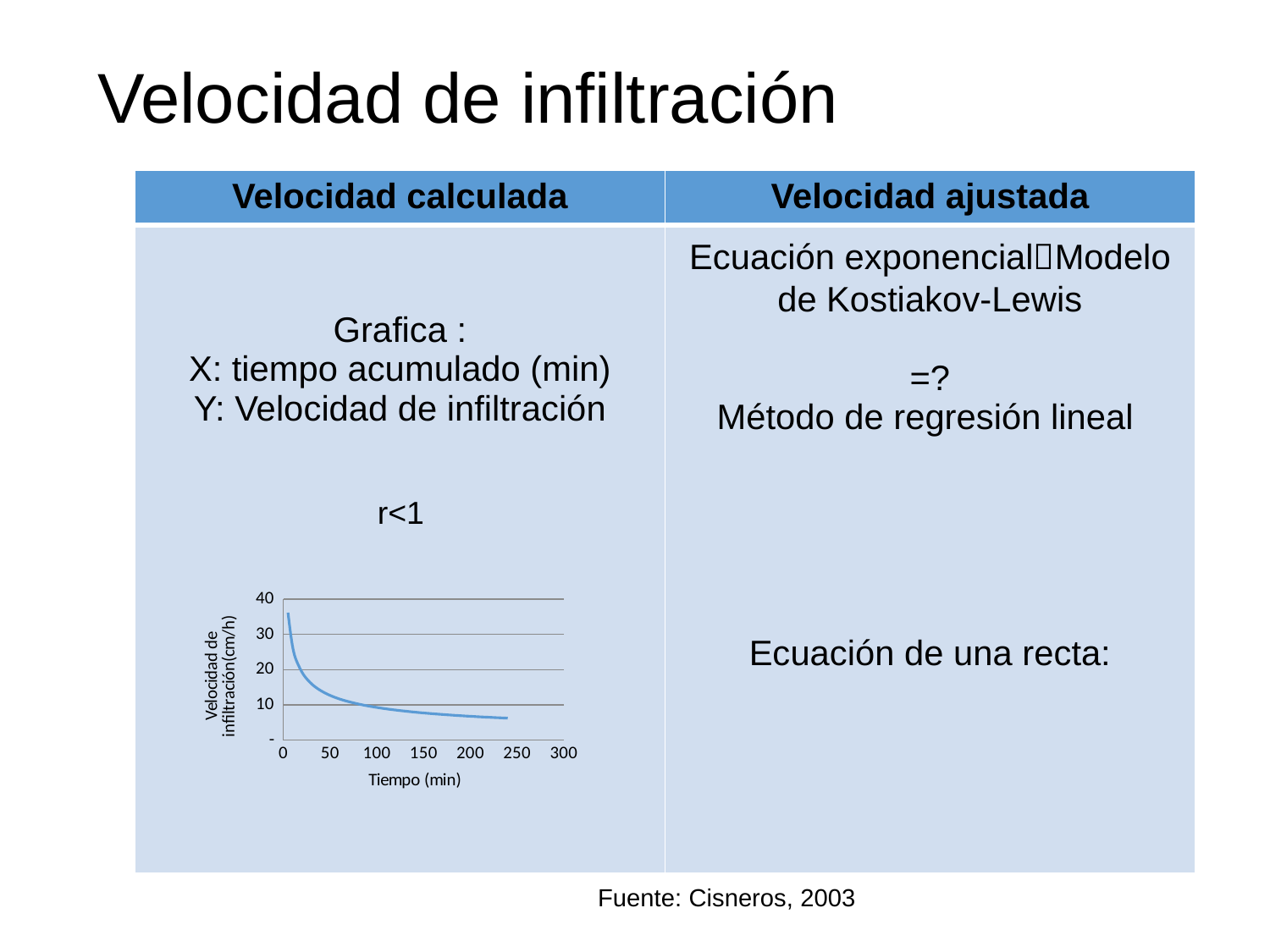
Is the value of the curve at 50 min greater or less than 20? less What is the label of the x axis of the chart? Tiempo (min) What is the label of the y axis of the chart? Velocidad de infiltración(cm/h) What kind of chart is shown on the slide? line chart Is the value of the curve at 50 min greater or less than 10? greater Which is larger: the value of the curve at 50 min or at 200 min? 50 min Do the values in the chart rise or fall as time (Tiempo) increases along the x axis? fall What is the highest tick value shown on the y axis of the chart? 40 Is the highest value of the curve, near the start of the x axis, greater or less than 30? greater